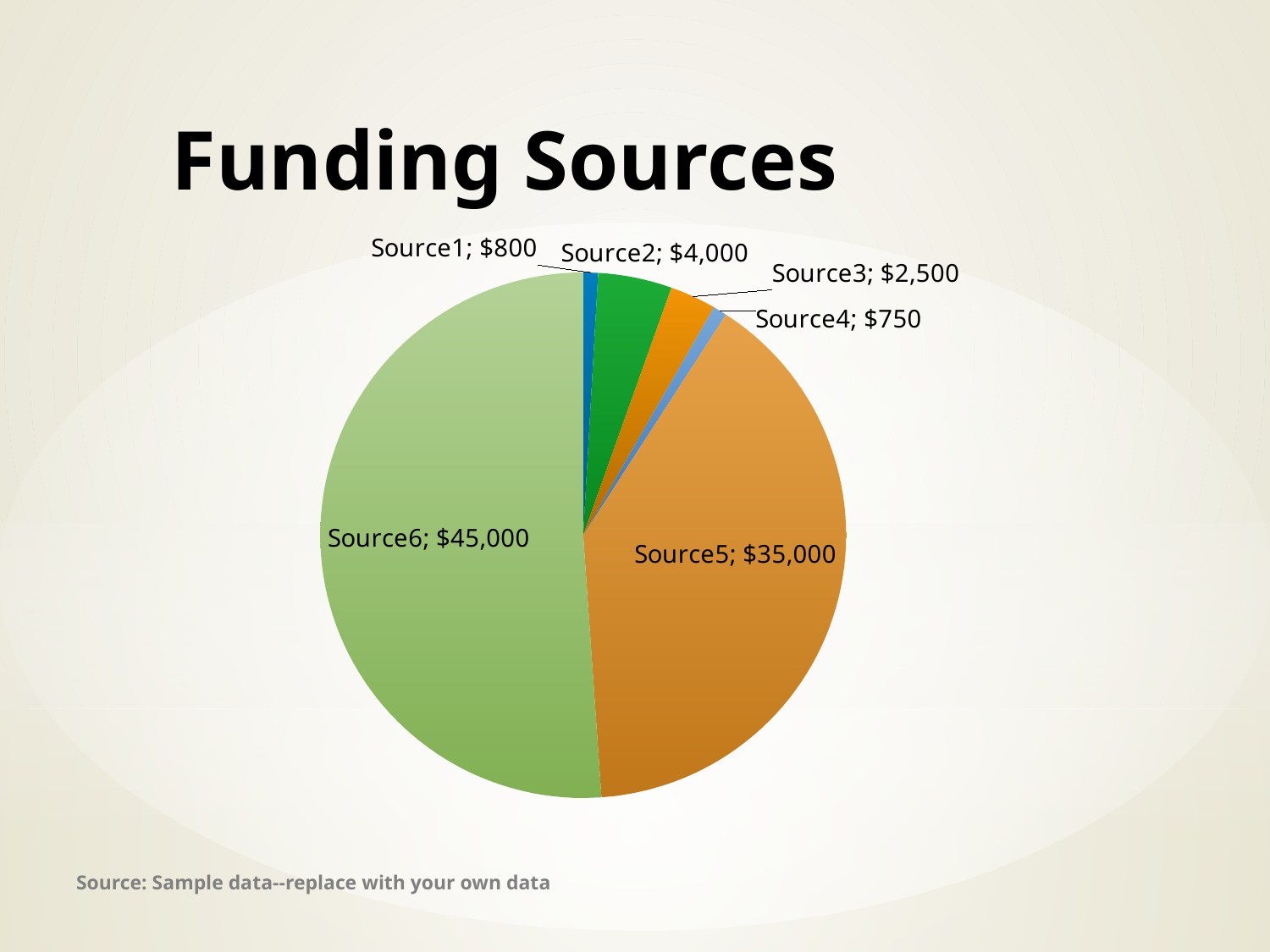
What kind of chart is shown on the slide? Pie chart What is the value for Source4? $750 Which is larger, the value for Source2 or the value for Source3? Source2 Which source has the smallest value? Source4 What is the title of the chart? Funding Sources What is the total of all the funding sources shown in the pie chart? $88,050 How many slices does the pie chart have? 6 What is the value for Source3? $2,500 What is the difference between the values for Source6 and Source5? $10,000 What is the difference between the values for Source2 and Source3? $1,500 What is the value for Source5? $35,000 Which source has the largest value? Source6